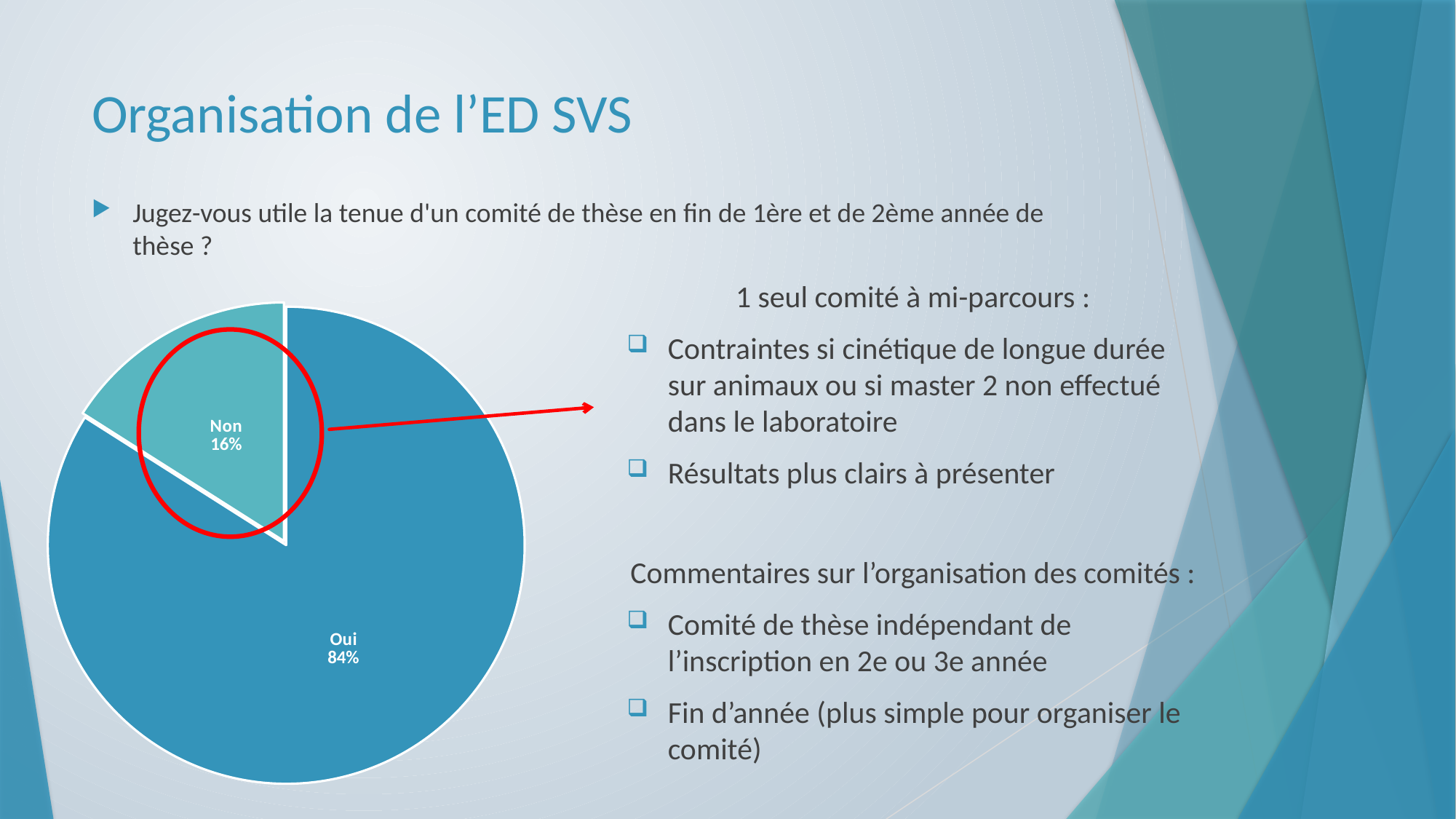
Which slice of the pie chart is circled in red? Non What percentage of the pie chart is labelled "Oui"? 84% Which slice of the pie chart is drawn in the lighter teal colour? Non Which slice of the pie chart is the largest? Oui Which slice of the pie chart is the smallest? Non What is the difference in percentage points between the "Oui" and "Non" slices? 68 Which slice is larger, "Oui" or "Non"? Oui What kind of chart is shown on the slide? pie chart What share of the pie does the "Non" slice represent? 16% What percentage of the pie chart is labelled "Non"? 16% How many slices does the pie chart have? 2